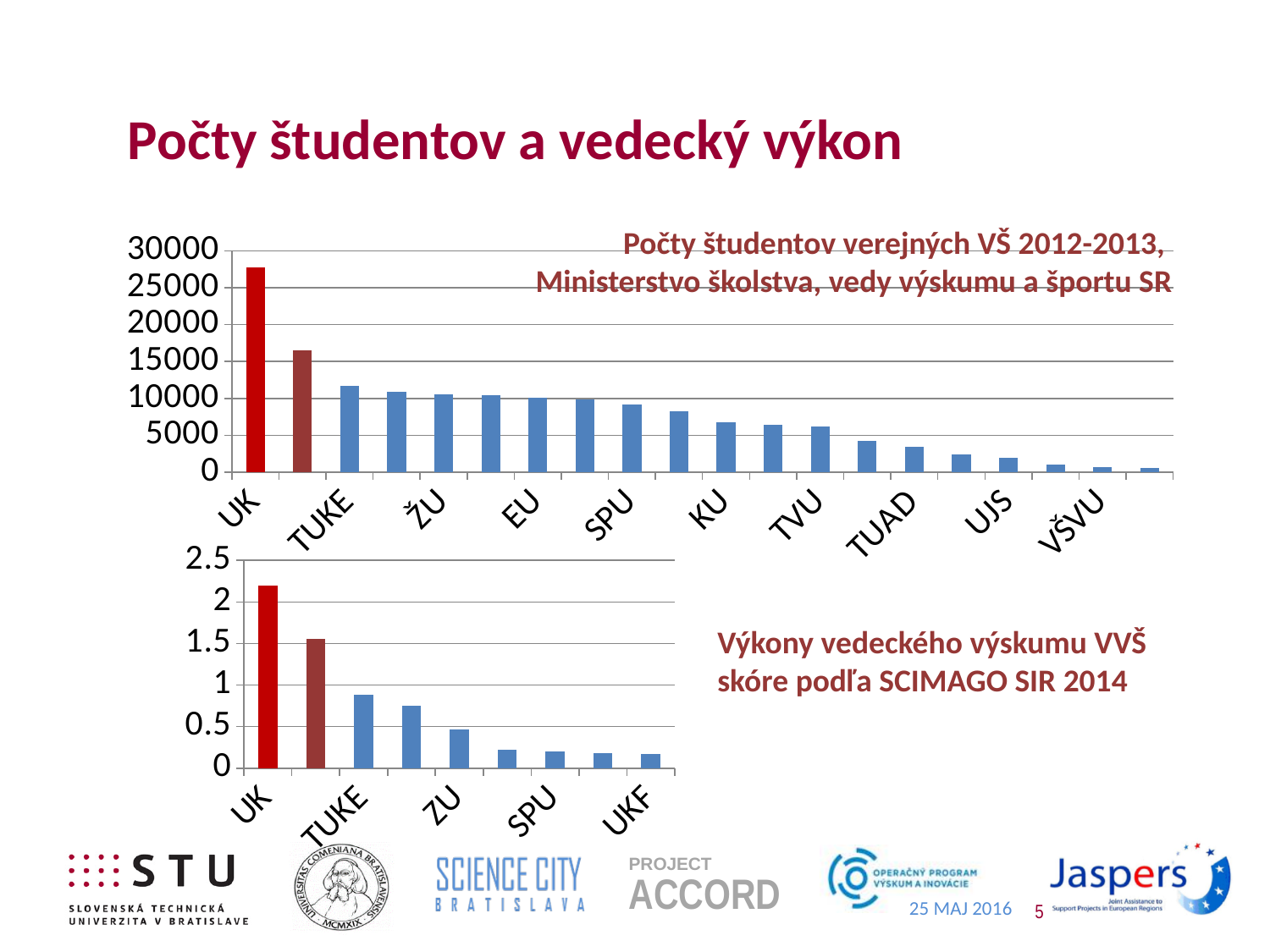
In the top chart (Počty študentov verejných VŠ 2012-2013), do the values rise or fall from left to right? fall In the top chart (Počty študentov verejných VŠ 2012-2013), is the value for UK greater or less than 25000? greater In the top chart (Počty študentov verejných VŠ 2012-2013), which is larger, the value for ŽU or the value for TUAD? ŽU How many bars are plotted in the bottom chart (Výkony vedeckého výskumu VVŠ skóre podľa SCIMAGO SIR 2014)? 9 In the bottom chart (Výkony vedeckého výskumu VVŠ skóre podľa SCIMAGO SIR 2014), is the value for UK greater or less than 2? greater In the bottom chart (Výkony vedeckého výskumu VVŠ skóre podľa SCIMAGO SIR 2014), is the value for SPU greater or less than 0.5? less In the bottom chart (Výkony vedeckého výskumu VVŠ skóre podľa SCIMAGO SIR 2014), which category has the highest value? UK In the top chart (Počty študentov verejných VŠ 2012-2013), which category has the highest value? UK What type of chart is the top chart on the slide? bar chart How many bars are plotted in the top chart (Počty študentov verejných VŠ 2012-2013)? 20